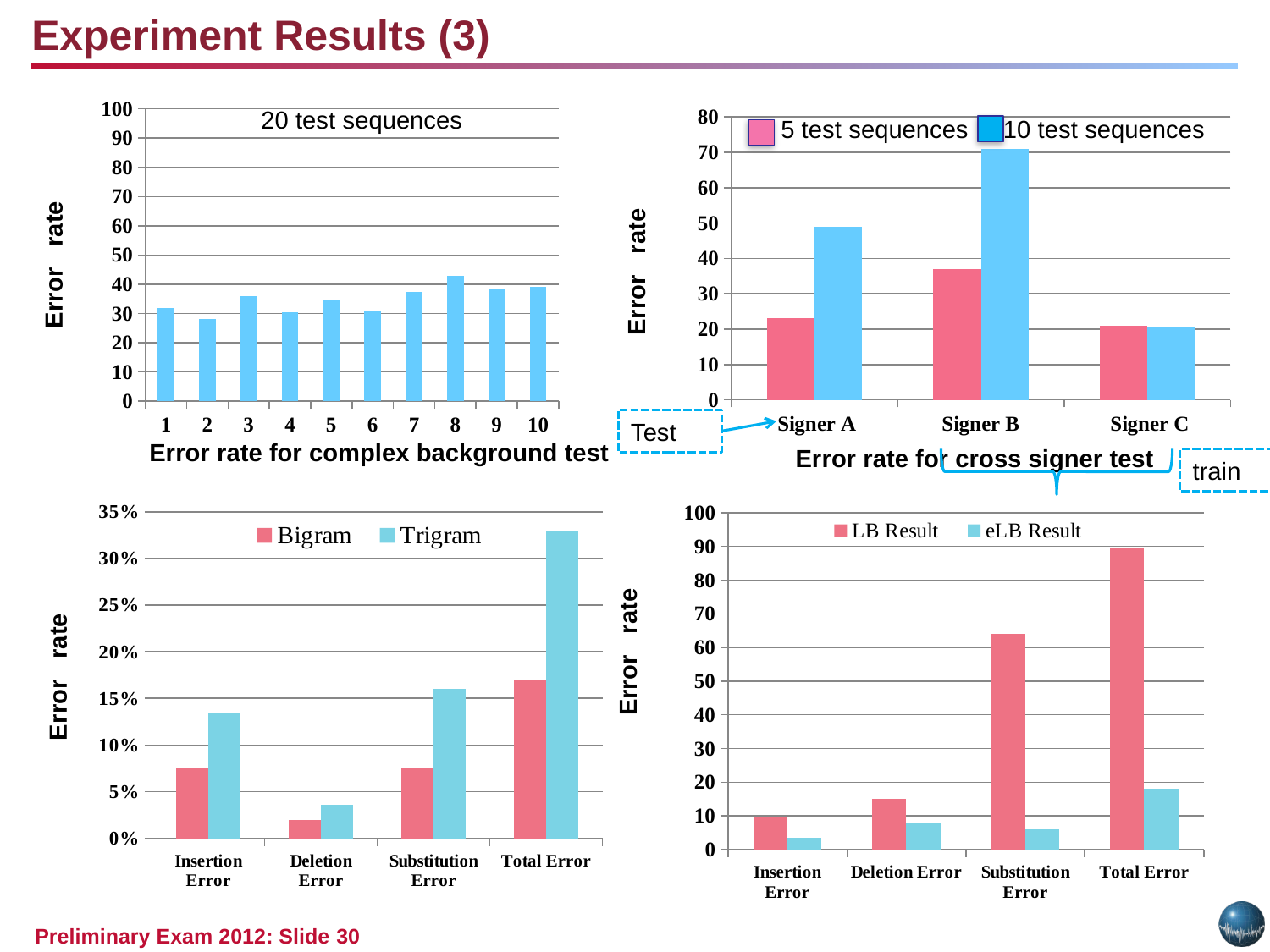
In the 'Error rate for complex background test' chart, how many test sequences are plotted on the x axis? 10 What kind of chart is the bottom-right chart comparing LB Result and eLB Result? bar chart In the 'Error rate for complex background test' chart, is the error rate for sequence 8 greater or less than 40? greater In the 'Error rate for cross signer test' chart, how many series does the legend list? 2 In the 'Error rate for complex background test' chart, which test sequence has the highest error rate? 8 In the bottom-left chart comparing Bigram and Trigram, is the Trigram value for Total Error greater or less than 30%? greater In the bottom-left chart comparing Bigram and Trigram, which is larger for Insertion Error: Bigram or Trigram? Trigram In the 'Error rate for cross signer test' chart, which signer has the highest error rate for 10 test sequences? Signer B In the bottom-right chart comparing LB Result and eLB Result, is the LB Result value for Total Error greater or less than 80? greater In the 'Error rate for complex background test' chart, which test sequence has the lowest error rate? 2 In the 'Error rate for cross signer test' chart, which is larger for Signer B: the 5 test sequences value or the 10 test sequences value? 10 test sequences